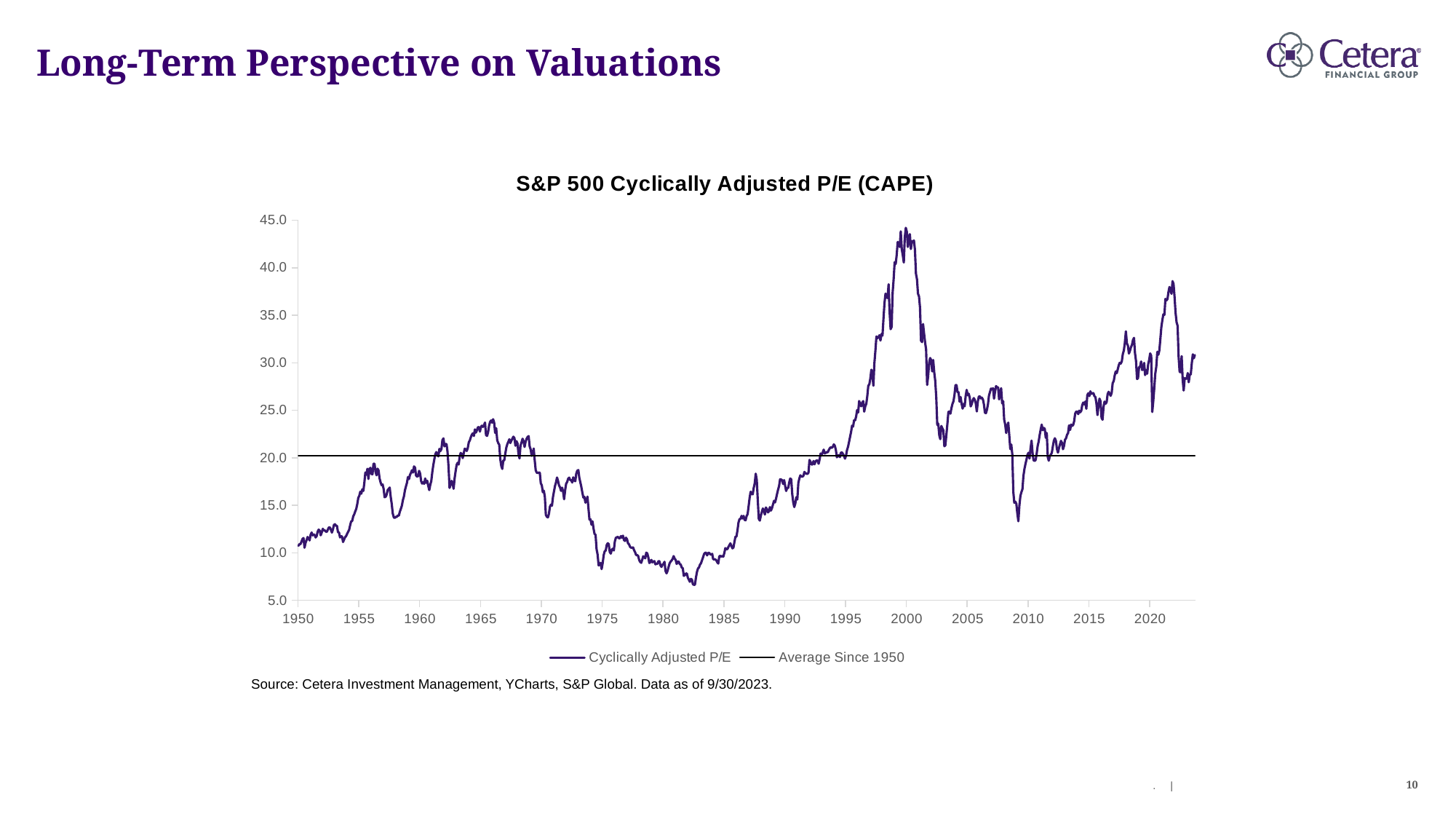
Which peak of the Cyclically Adjusted P/E is higher: the one around 2000 or the one around 2021? Around 2000 How many series does the legend list? 2 Around which year does the Cyclically Adjusted P/E reach its lowest point? 1982 Around which year does the Cyclically Adjusted P/E reach its highest point? 2000 What kind of chart is shown on the slide? Line chart Is the Cyclically Adjusted P/E in 1950 greater or less than 15.0? less What is the title of the chart? S&P 500 Cyclically Adjusted P/E (CAPE) Is the peak value of the Cyclically Adjusted P/E around 2000 greater or less than 40.0? greater Does the Cyclically Adjusted P/E rise or fall between 1995 and 2000? Rise Is the Cyclically Adjusted P/E at its low point around 1982 greater or less than 10.0? less What are the two entries in the chart's legend? Cyclically Adjusted P/E; Average Since 1950